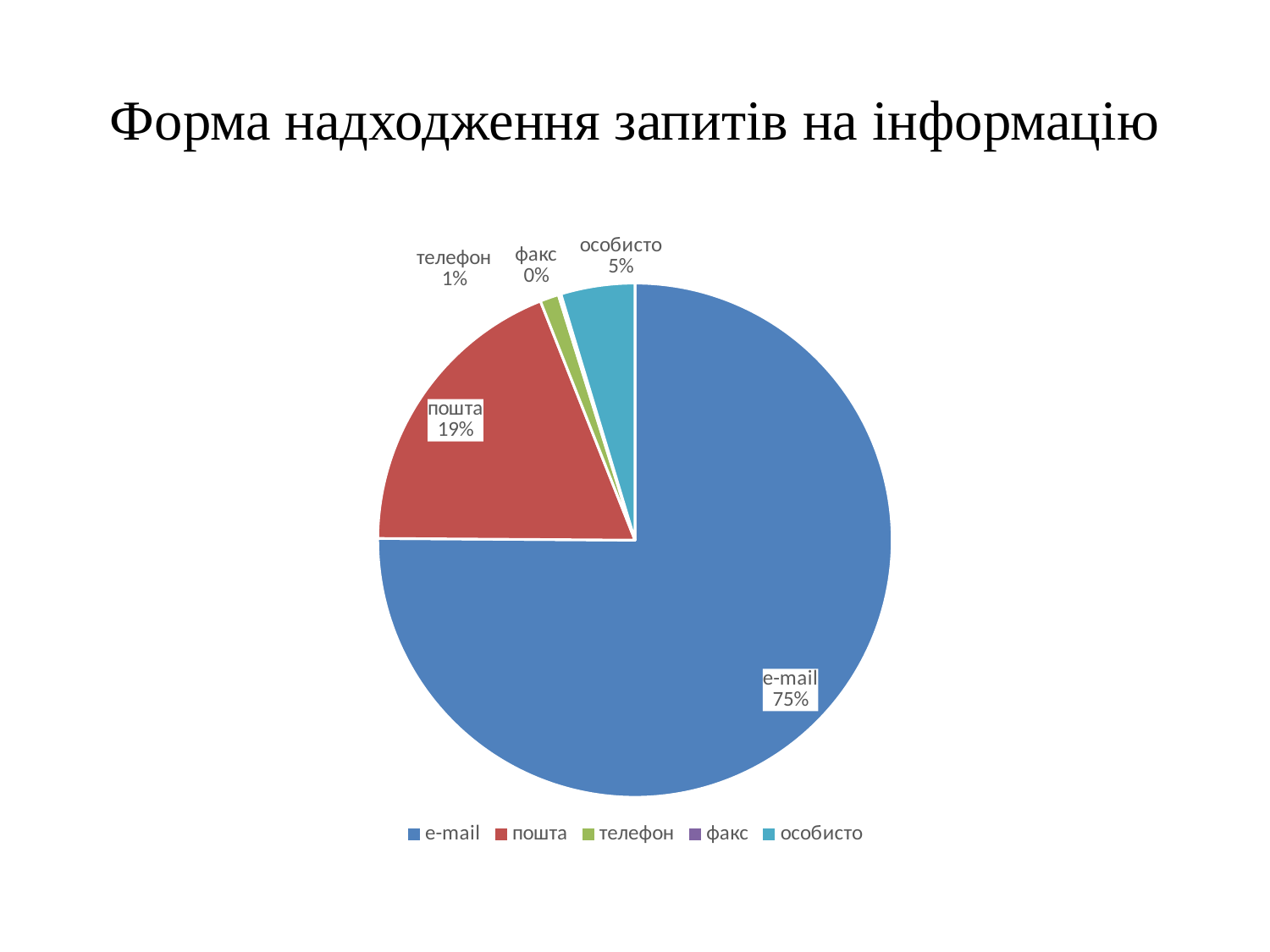
What is the difference in percentage points between e-mail and пошта? 56 What share of the pie does пошта account for? 19% What share of the pie does особисто account for? 5% Which category has the largest share of the pie? e-mail Which category has the smallest share of the pie? факс What share of the pie does e-mail account for? 75% What is the title of the chart on the slide? Форма надходження запитів на інформацію Which is larger, the share for пошта or the share for особисто? пошта What kind of chart is shown on the slide? pie chart How many categories does the pie chart show? 5